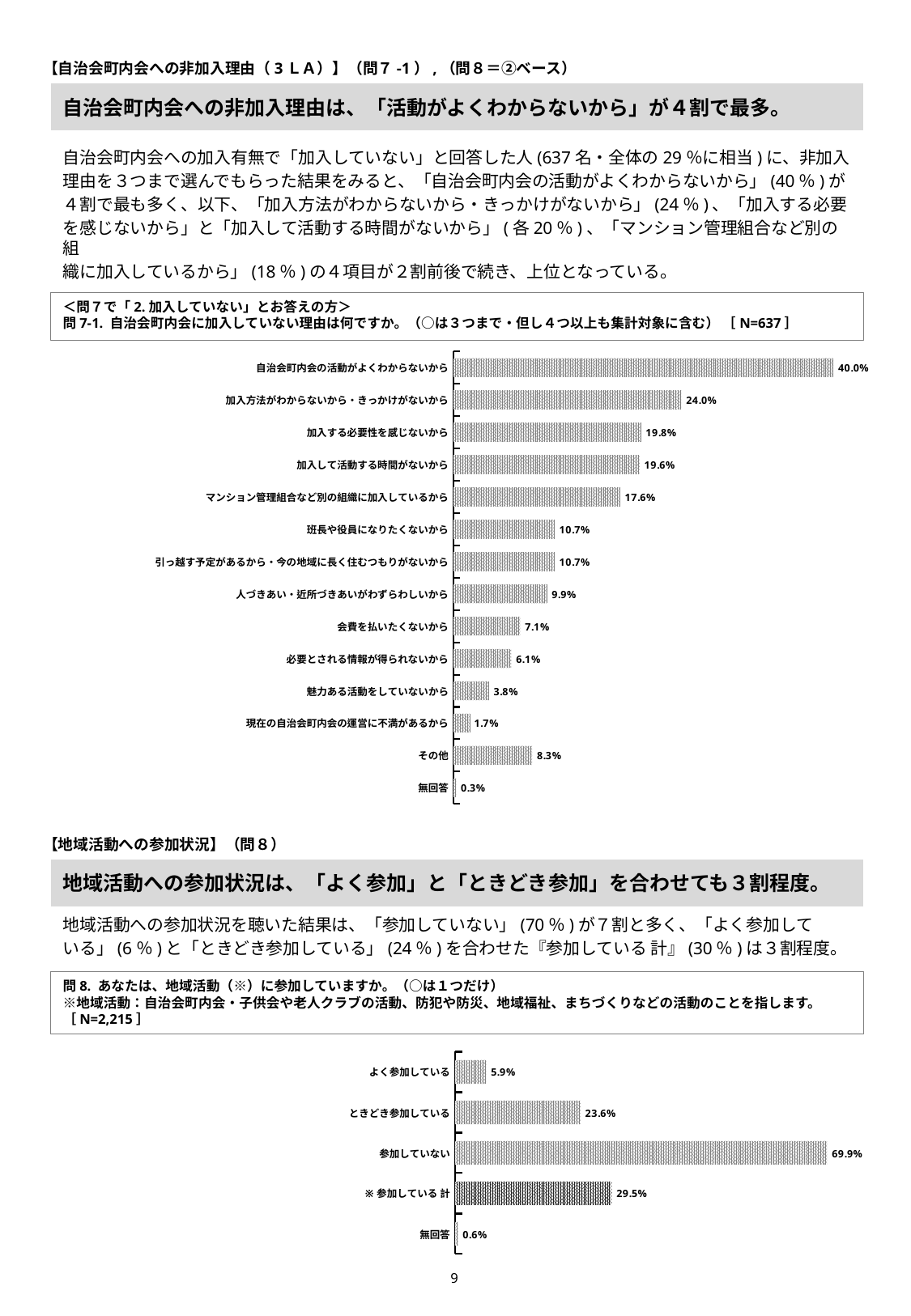
In the top chart (問7-1), what is the difference between 「加入方法がわからないから・きっかけがないから」 and 「マンション管理組合など別の組織に加入しているから」? 6.4% In the top chart (問7-1), how many categories are plotted? 14 In the bottom chart (問8), which category has the highest value? 参加していない In the bottom chart (問8), what is the value for 「参加していない」? 69.9% What kind of chart is the top chart (問7-1)? Bar chart In the top chart (問7-1), what is the value for 「自治会町内会の活動がよくわからないから」? 40.0% In the top chart (問7-1), which is larger: 「会費を払いたくないから」 or 「その他」? その他 In the bottom chart (問8), what is the difference between 「ときどき参加している」 and 「よく参加している」? 17.7% In the bottom chart (問8), how many categories are plotted? 5 In the top chart (問7-1), what is the value for 「現在の自治会町内会の運営に不満があるから」? 1.7% In the top chart (問7-1), which category has the highest value? 自治会町内会の活動がよくわからないから In the top chart (問7-1), which category has the lowest value? 無回答